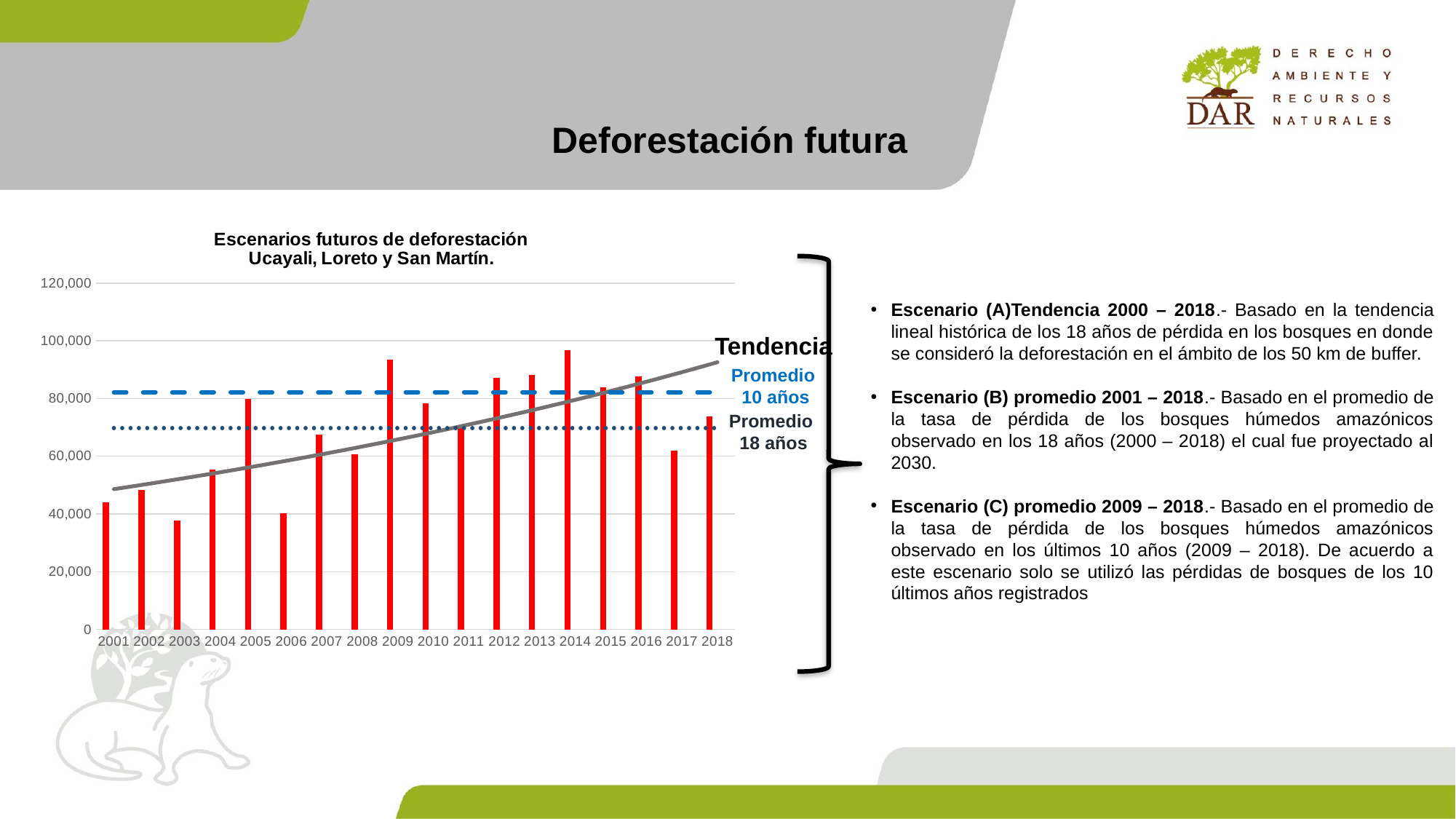
Which year has the larger bar, 2016 or 2017? 2016 Is the value for 2006 greater or less than 60,000? less Does the Tendencia line rise or fall from 2001 to 2018? Rises Which year has the highest bar in the chart? 2014 Is the value for 2009 greater or less than 80,000? greater What kind of chart is shown on the slide? Bar chart Is the value for 2017 greater or less than 80,000? less What is the title of the chart? Escenarios futuros de deforestación Ucayali, Loreto y San Martín. How many years are plotted on the x axis of the chart? 18 Which year has the larger bar, 2009 or 2010? 2009 Which year has the larger bar, 2003 or 2004? 2004